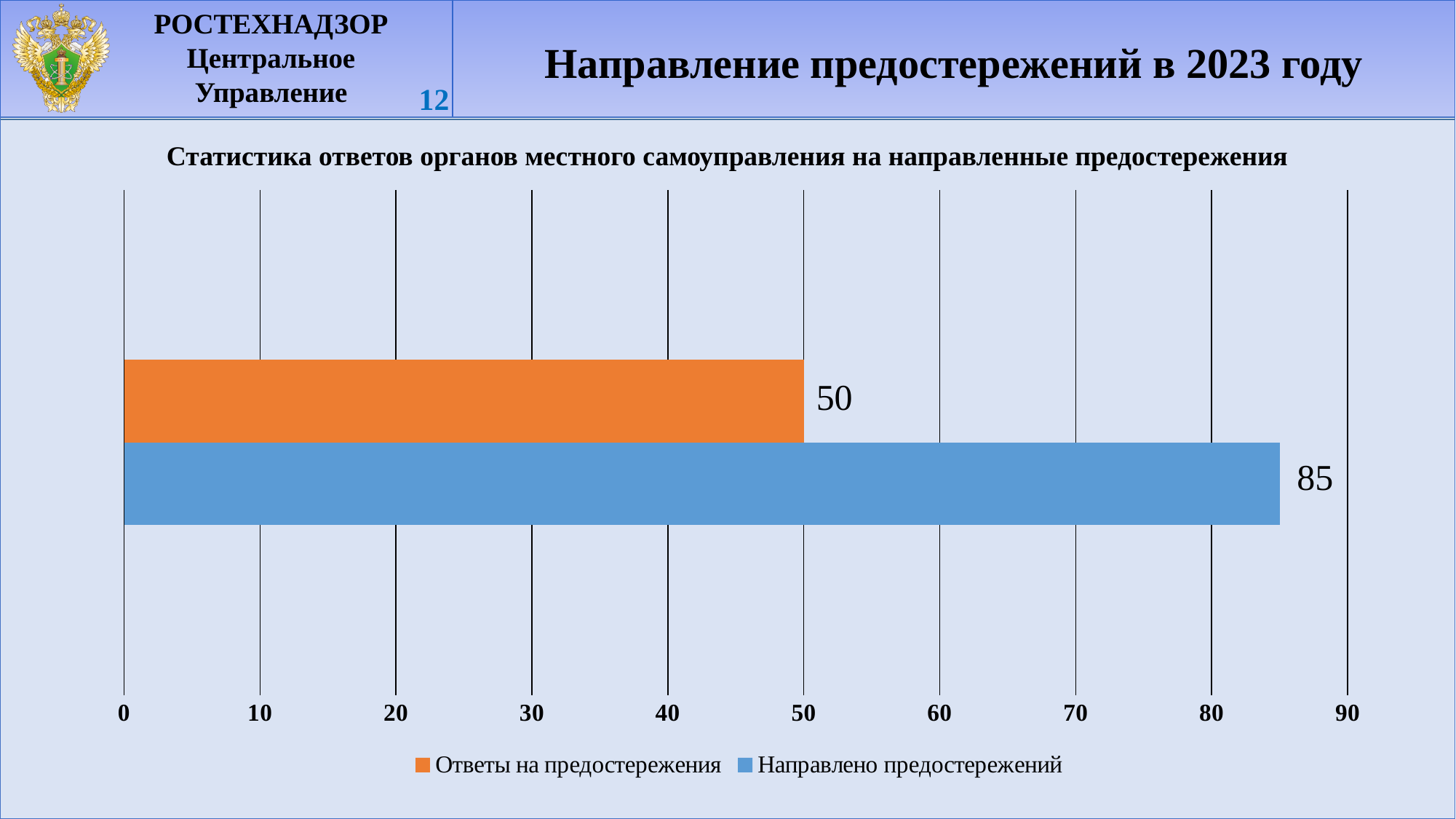
Which series has the lowest value? Ответы на предостережения What kind of chart is shown on the slide? Bar chart Is the value for "Ответы на предостережения" greater or less than 60? less How many series does the legend list? 2 What colour is the bar for "Направлено предостережений"? Blue Which series has the highest value? Направлено предостережений What is the value for "Направлено предостережений"? 85 Which series has the higher value, "Ответы на предостережения" or "Направлено предостережений"? Направлено предостережений What is the difference between "Направлено предостережений" and "Ответы на предостережения"? 35 What is the value for "Ответы на предостережения"? 50 What is the title of the chart? Статистика ответов органов местного самоуправления на направленные предостережения Is the value for "Направлено предостережений" greater or less than 80? greater